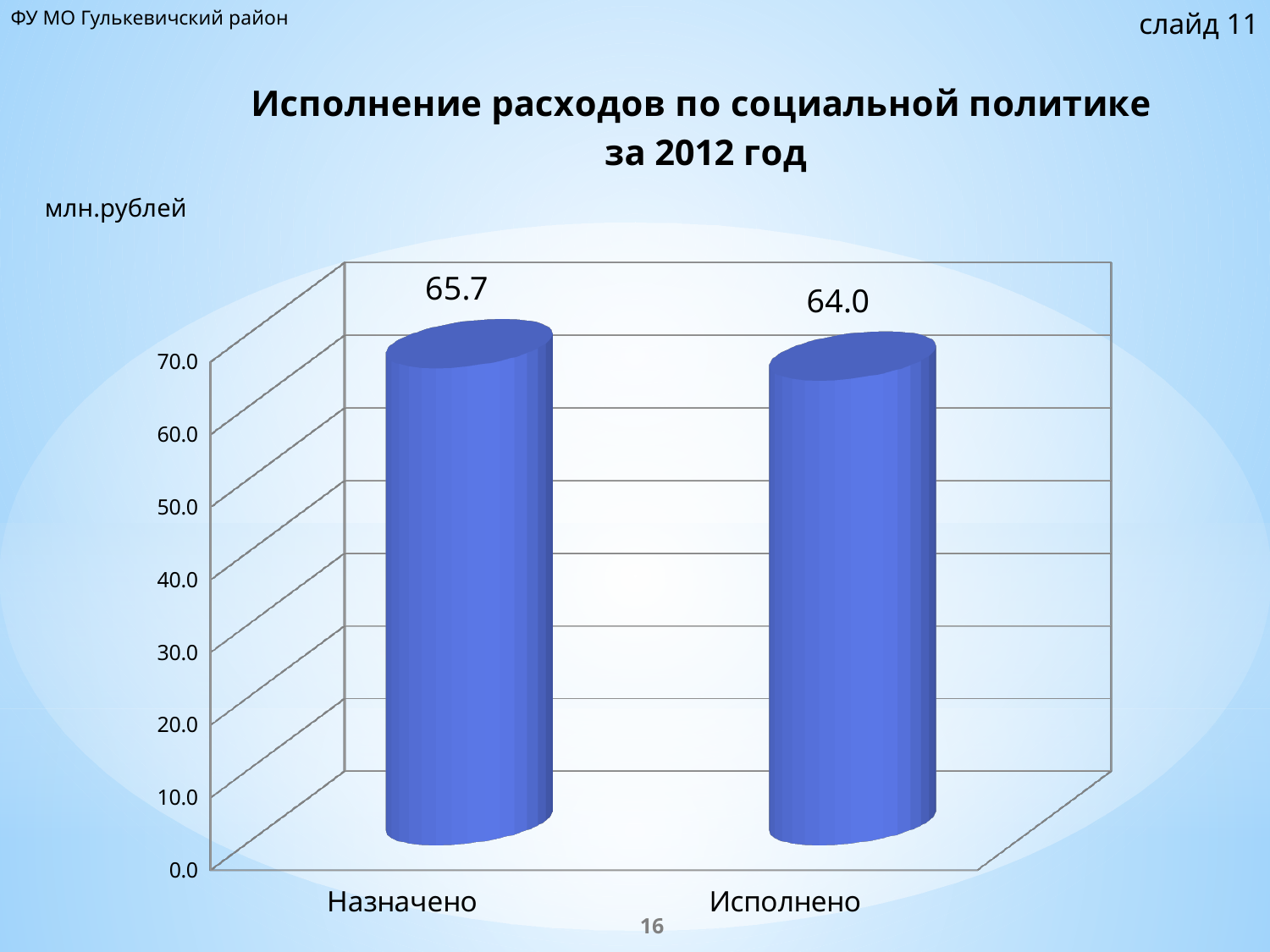
What unit is indicated for the values on the chart? млн.рублей Which category has the highest value? Назначено What is the difference between the values for Назначено and Исполнено? 1.7 What is the value for Назначено? 65.7 Which is larger, the value for Назначено or the value for Исполнено? Назначено What kind of chart is shown on the slide? bar chart How many categories are shown on the chart? 2 What is the value for Исполнено? 64.0 Which category has the lowest value? Исполнено Is the value for Исполнено greater or less than 60.0? greater What is the title of the chart? Исполнение расходов по социальной политике за 2012 год Is the value for Назначено greater or less than 70.0? less